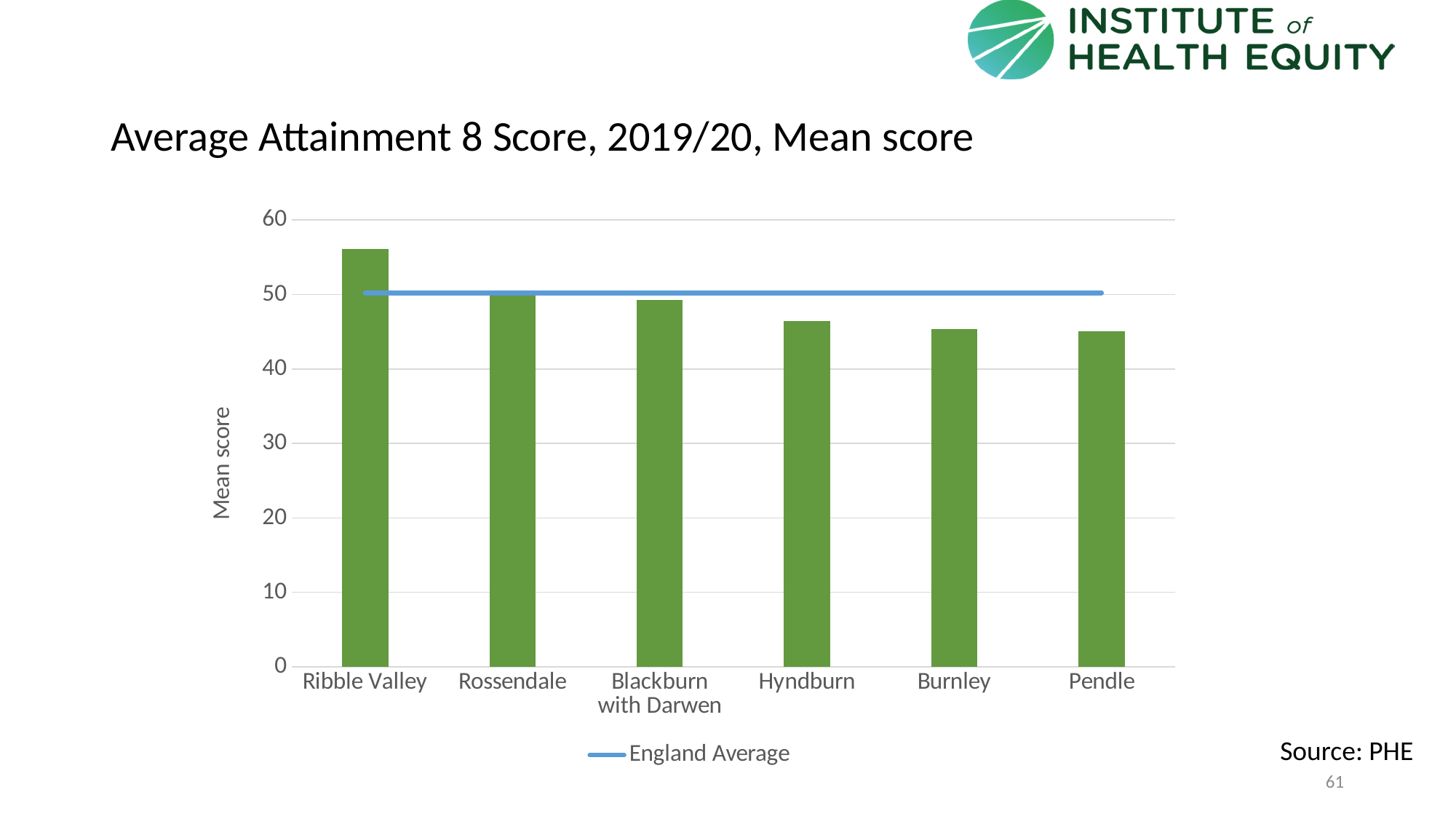
How many local authorities (bars) are shown on the chart? 6 Which has a higher mean score, Rossendale or Hyndburn? Rossendale Is the value for Blackburn with Darwen greater or less than 40? greater What kind of chart is shown on the slide? Bar chart What is the title of the chart? Average Attainment 8 Score, 2019/20, Mean score What does the blue horizontal line on the chart represent, according to the legend? England Average Is the value for Hyndburn greater or less than 50? less Is the value for Ribble Valley greater or less than 50? greater Do the bar values rise or fall from left to right across the chart? Fall Which local authority has the highest Average Attainment 8 Score? Ribble Valley Which has a higher mean score, Ribble Valley or Pendle? Ribble Valley